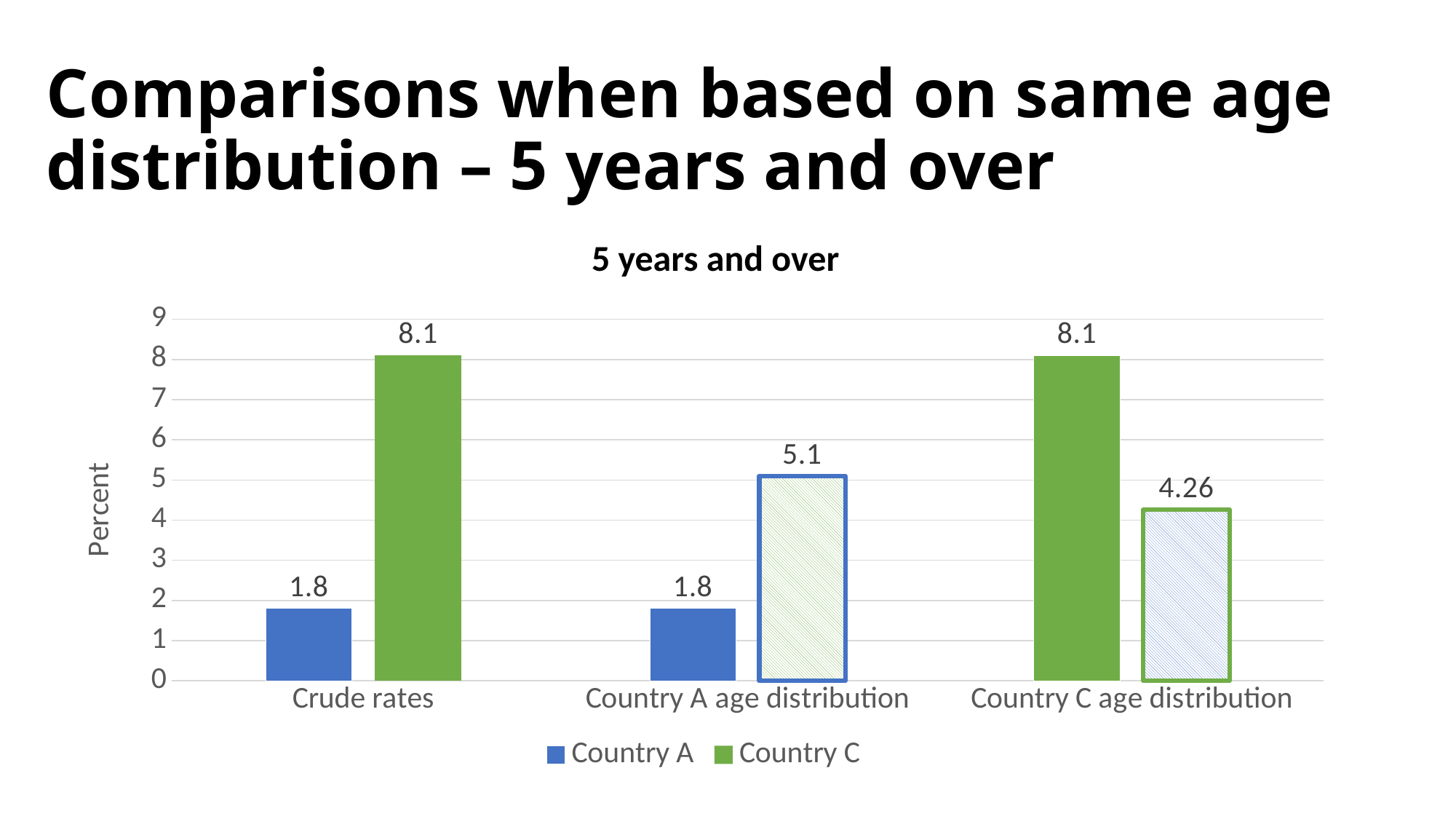
What is the difference between Country C and Country A under Crude rates? 6.3 Which category has the highest value for Country A? Country C age distribution Which is larger under Country A age distribution: Country A or Country C? Country C What is the value for Country C under Country A age distribution? 5.1 What type of chart is shown? Bar chart What is the value for Country A under Crude rates? 1.8 How many series does the legend list? 2 How many categories are shown on the x axis? 3 What is the value for Country C under Crude rates? 8.1